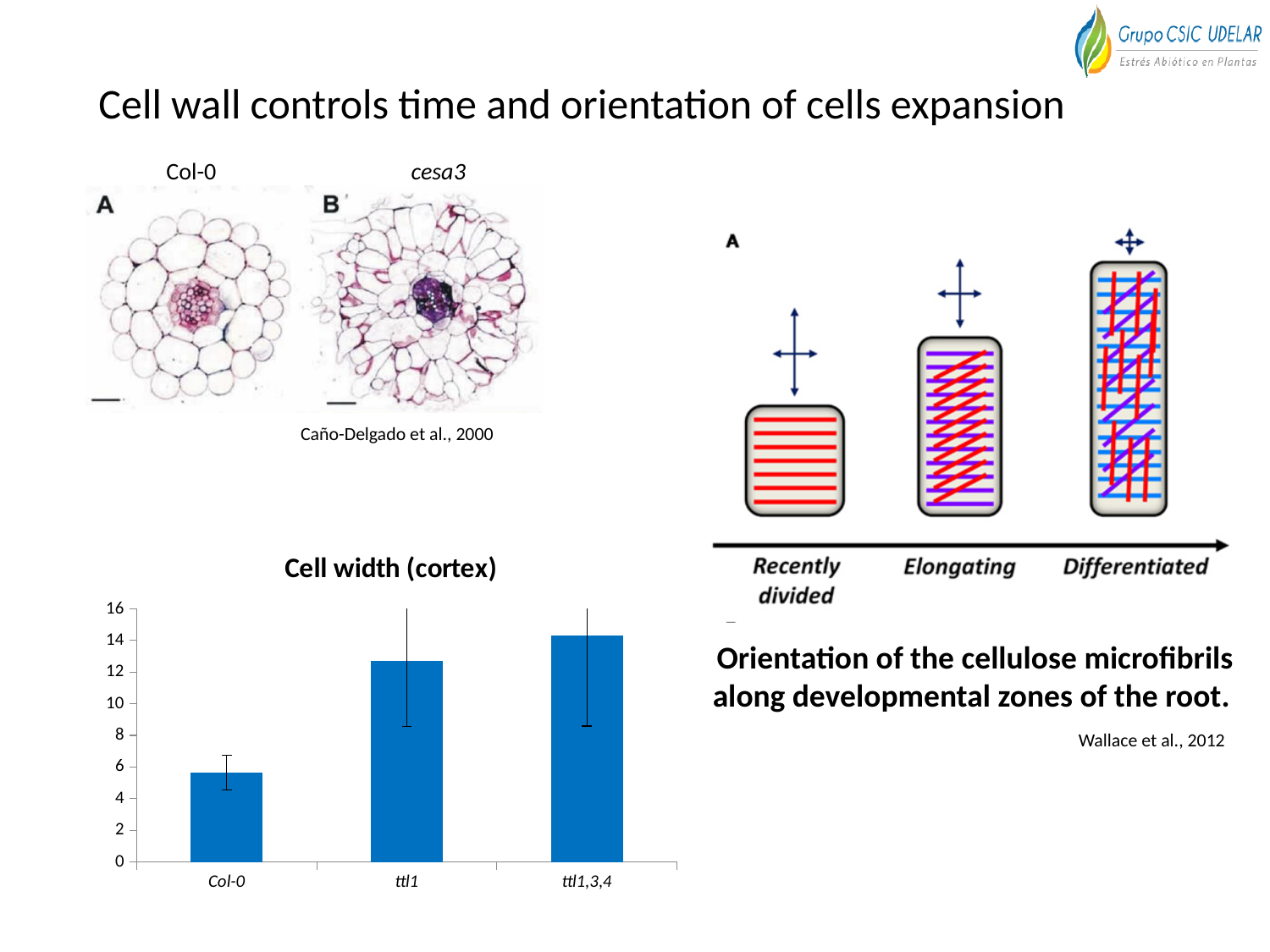
In the "Cell width (cortex)" chart, is the value for ttl1,3,4 greater or less than 12? greater In the "Cell width (cortex)" chart, is the value for Col-0 greater or less than 4? greater What is the title of the bar chart on the slide? Cell width (cortex) How many categories are shown on the x axis of the "Cell width (cortex)" chart? 3 In the "Cell width (cortex)" chart, which category has the lowest value? Col-0 In the "Cell width (cortex)" chart, is the value for Col-0 greater or less than 8? less In the "Cell width (cortex)" chart, do the values rise or fall from Col-0 to ttl1,3,4 along the x axis? rise What kind of chart is the "Cell width (cortex)" chart? bar chart In the "Cell width (cortex)" chart, which category has the highest value? ttl1,3,4 In the "Cell width (cortex)" chart, which is larger, the value for Col-0 or the value for ttl1? ttl1